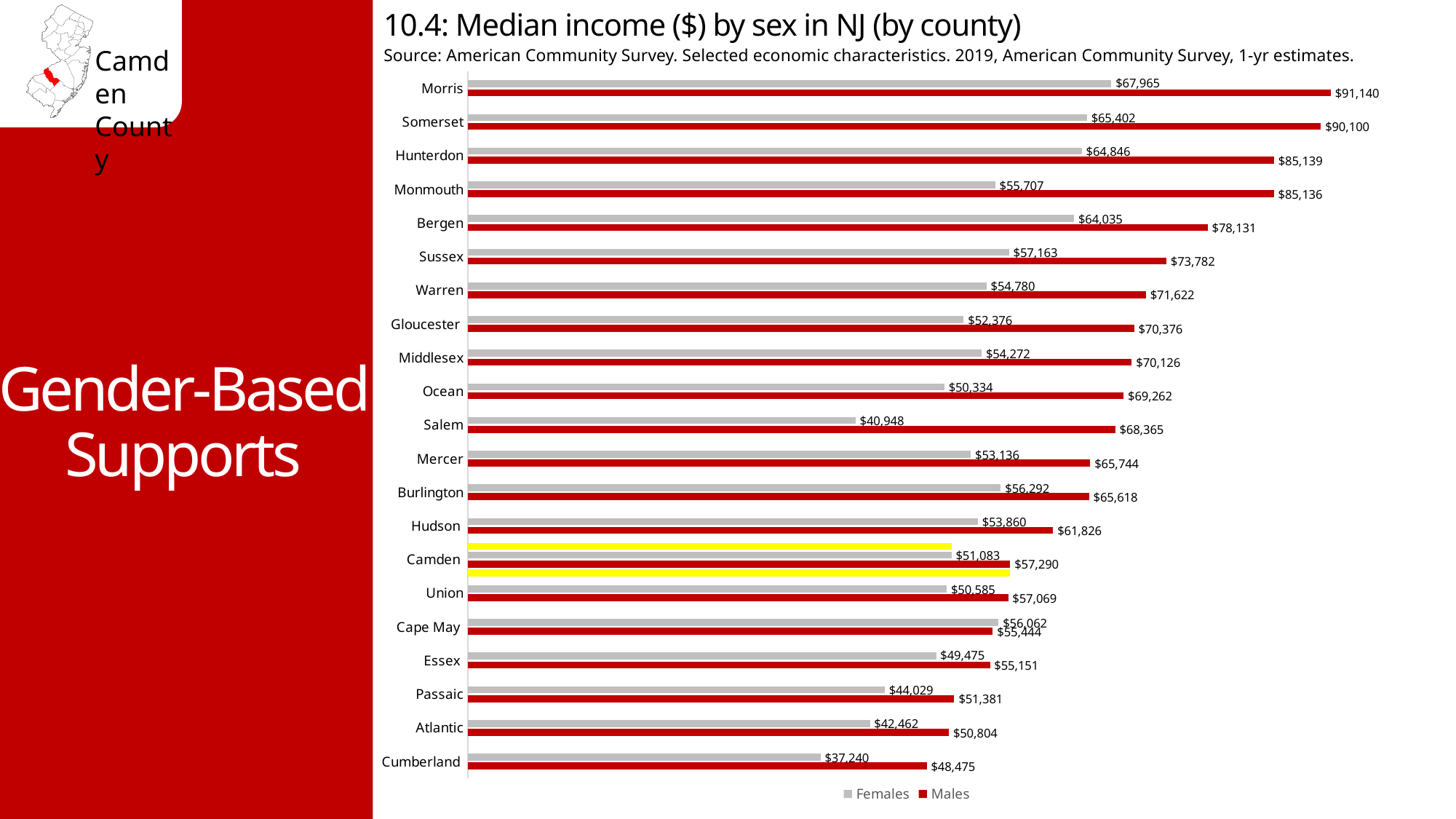
How many series does the legend list? 2 What is the median income for males in Morris County? $91,140 Which county has the highest median income for males? Morris What is the difference between male and female median income in Camden County? $6,207 In Cape May County, which is larger: the median income for females or for males? Females How many counties are shown in the chart? 21 What is the median income for females in Cumberland County? $37,240 Which county is highlighted in yellow on the chart? Camden What is the median income for males in Camden County? $57,290 What is the median income for females in Camden County? $51,083 What type of chart is shown on the slide? Bar chart Which county has the lowest median income for females? Cumberland